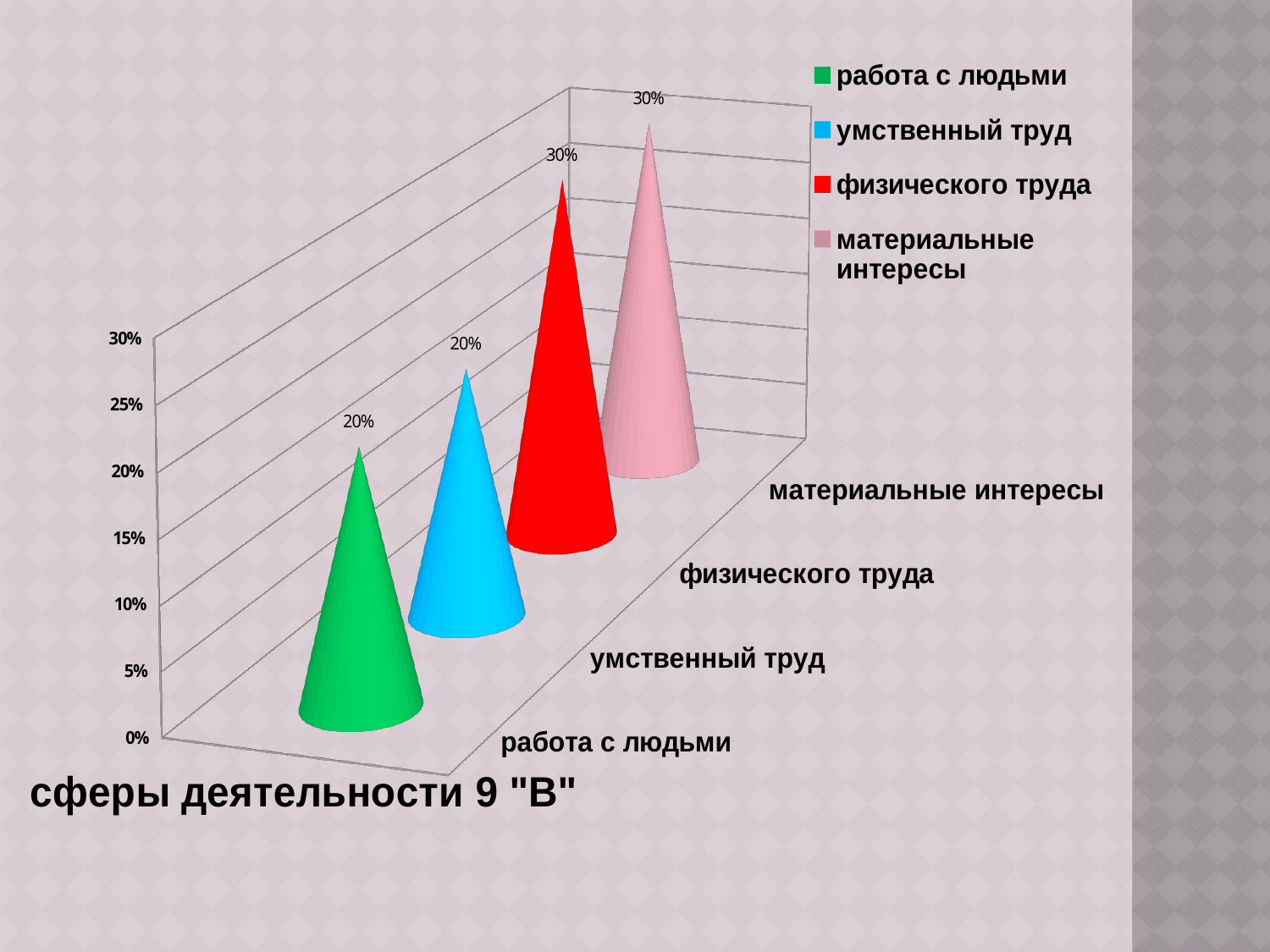
How many categories are plotted on the chart? 4 Is the value for физического труда greater or less than 25%? greater Is the value for работа с людьми greater or less than 25%? less Which is larger, the value for умственный труд or the value for материальные интересы? материальные интересы What is the value for физического труда? 30% What is the difference between the value for материальные интересы and the value for умственный труд? 10% What kind of chart is shown on the slide? bar chart What is the value for материальные интересы? 30% Which is larger, the value for физического труда or the value for работа с людьми? физического труда What is the value for умственный труд? 20% What is the value for работа с людьми? 20% How many entries does the legend list? 4